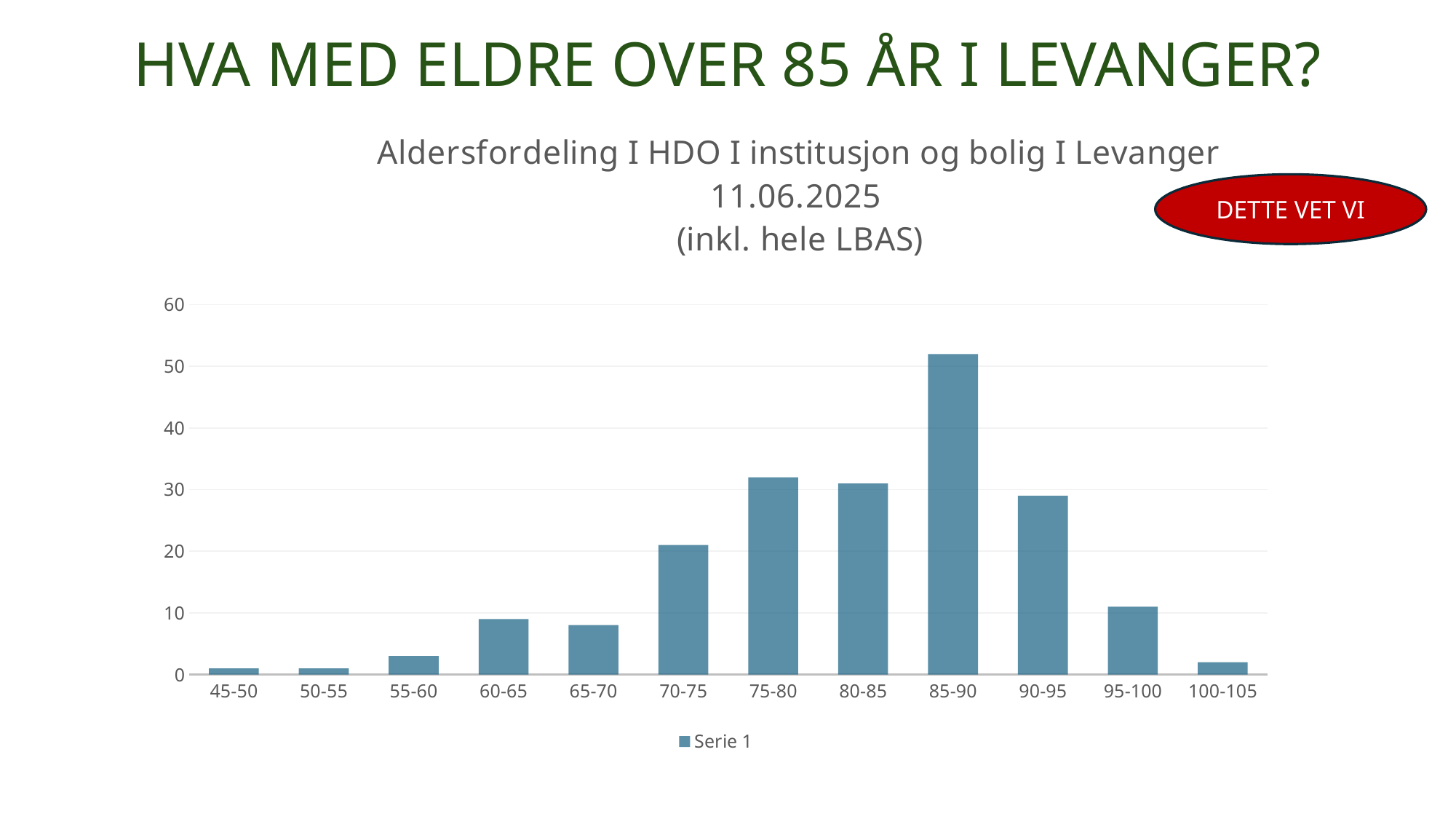
What is the name of the series shown in the legend? Serie 1 Which age group has the highest bar? 85-90 Is the value for 100-105 greater or less than 10? less How many series does the legend list? 1 Is the value for 85-90 greater or less than 50? greater How many age-group categories are shown on the x axis? 12 Which is larger, the value for 70-75 or the value for 75-80? 75-80 Which is larger, the value for 85-90 or the value for 90-95? 85-90 What date is given in the chart title? 11.06.2025 What kind of chart is shown on the slide? bar chart